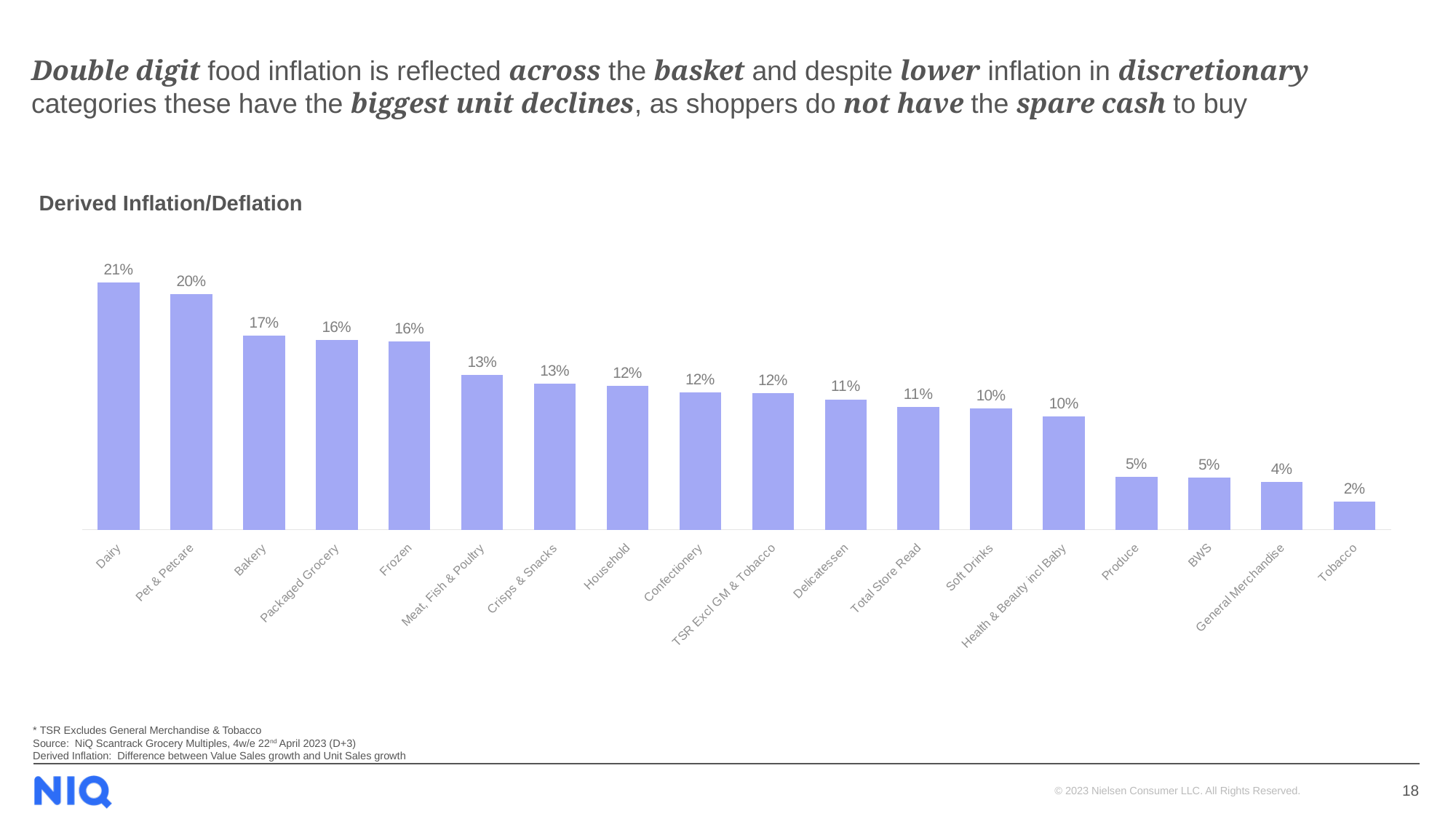
Which has a higher derived inflation value, Pet & Petcare or Household? Pet & Petcare How many categories are shown in the chart? 18 Which category has the highest derived inflation? Dairy What is the derived inflation value for Tobacco? 2% What type of chart is shown on the slide? Bar chart What is the title of the chart? Derived Inflation/Deflation What is the derived inflation value for Dairy? 21% What is the difference between the derived inflation for Dairy and for Produce? 16% What is the derived inflation value for Soft Drinks? 10% What is the derived inflation value for Bakery? 17% Which category has the lowest derived inflation? Tobacco Do the values rise or fall moving from left to right across the chart? Fall